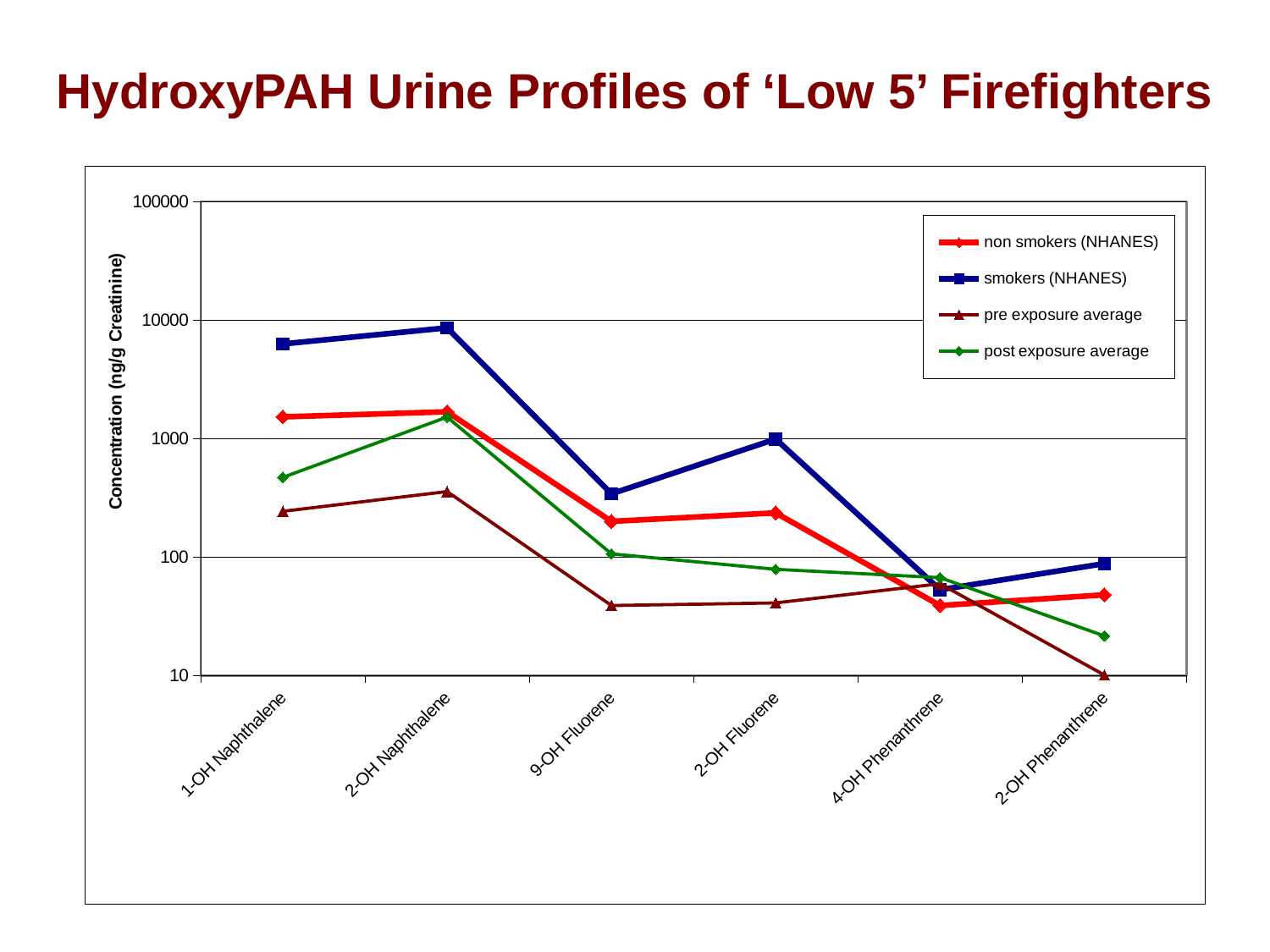
Is the value for post exposure average at 2-OH Naphthalene greater or less than 1000? greater For the pre exposure average series, which category has the lowest value? 2-OH Phenanthrene What kind of chart is shown on the slide? line chart Is the value for pre exposure average at 9-OH Fluorene greater or less than 100? less At 4-OH Phenanthrene, which is larger: post exposure average or non smokers (NHANES)? post exposure average How many series does the legend list? 4 Does the smokers (NHANES) series rise or fall from 2-OH Naphthalene to 9-OH Fluorene? fall For the smokers (NHANES) series, which category has the highest value? 2-OH Naphthalene Is the value for smokers (NHANES) at 1-OH Naphthalene greater or less than 1000? greater At 1-OH Naphthalene, which is larger: smokers (NHANES) or non smokers (NHANES)? smokers (NHANES) How many categories are shown along the x axis? 6 What is the label on the y axis? Concentration (ng/g Creatinine)